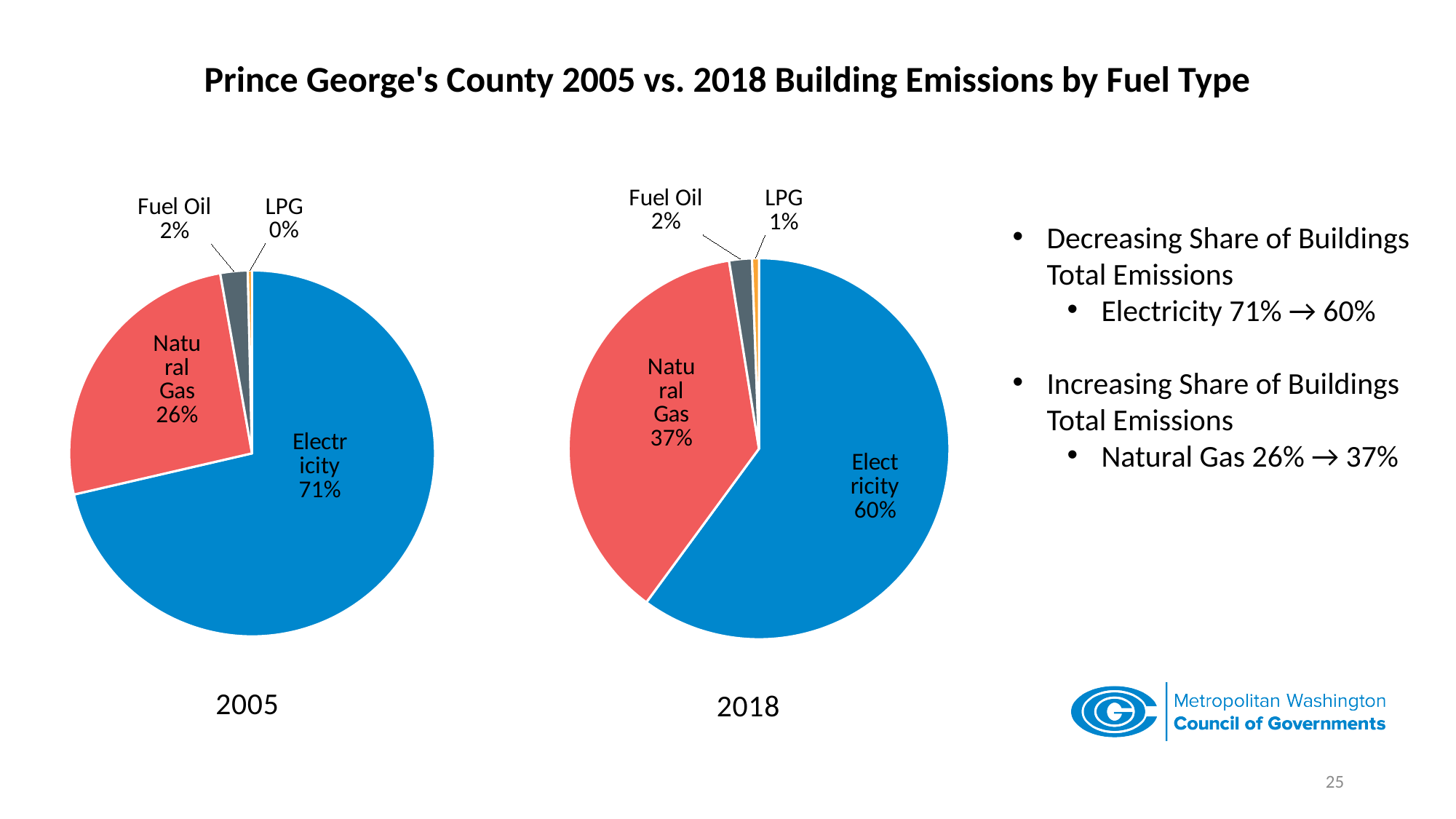
How many fuel type slices does the 2018 pie chart show? 4 In the 2005 pie chart, which fuel type has the smallest share? LPG What is the difference between the Electricity share in 2005 and in 2018? 11% In the 2005 pie chart, what share is shown for LPG? 0% In the 2018 pie chart, what share is shown for Fuel Oil? 2% In the 2018 pie chart, which fuel type has the largest share? Electricity What type of chart is used to show the 2005 building emissions by fuel type? Pie chart What is the title of the slide's charts? Prince George's County 2005 vs. 2018 Building Emissions by Fuel Type Is the Natural Gas share larger in the 2005 pie chart or the 2018 pie chart? 2018 In the 2018 pie chart, what share of building emissions comes from Natural Gas? 37% What is the difference between the Natural Gas share in 2018 and in 2005? 11% In the 2005 pie chart, what share of building emissions comes from Electricity? 71%